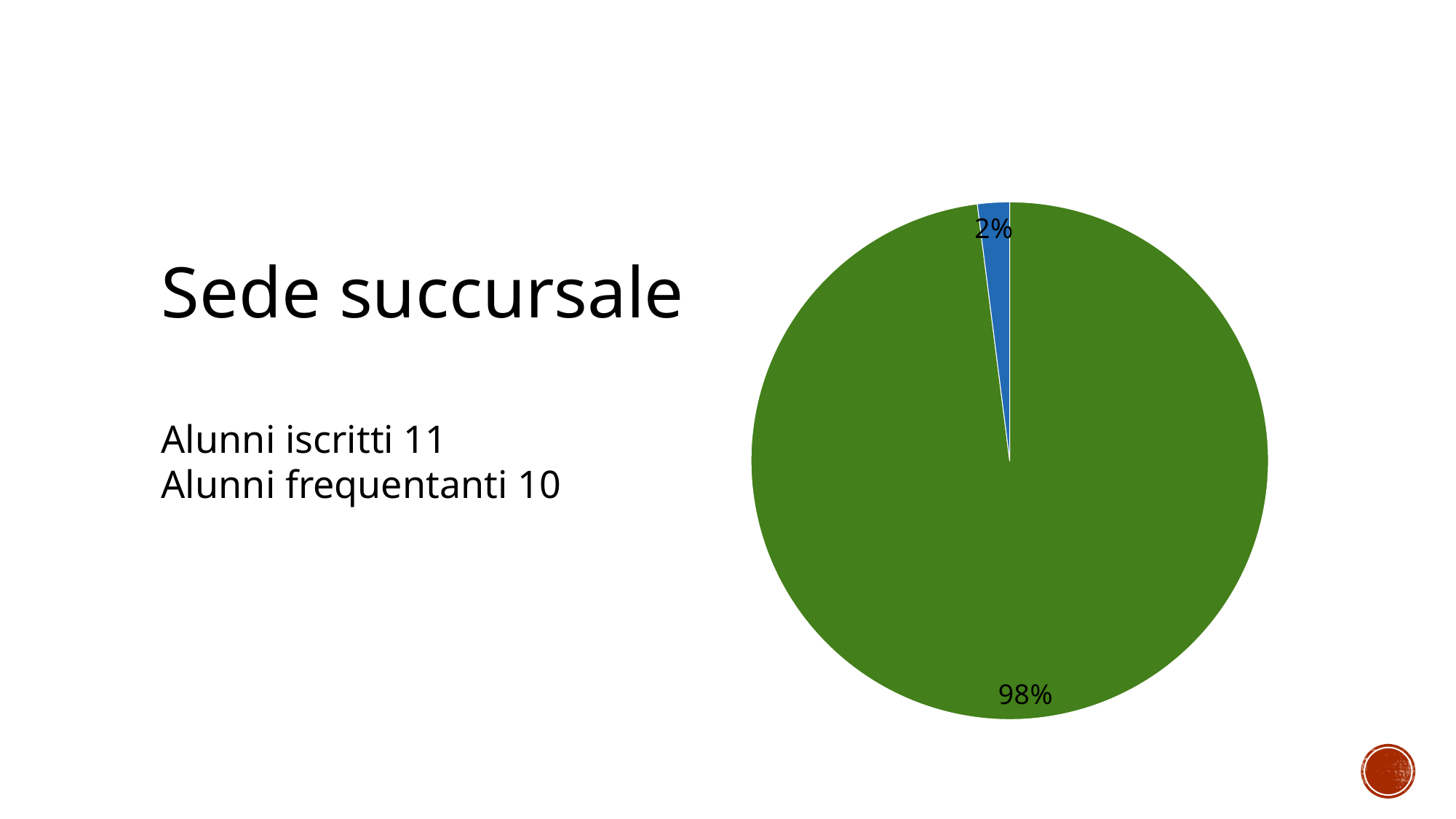
What percentage is shown on the green slice of the pie chart? 98% Is the share of the blue slice greater or less than 50%? less What colour is the slice labelled 98%? green What percentage is shown on the blue slice of the pie chart? 2% Which slice of the pie chart is the largest? the green slice (98%) What kind of chart is shown on the slide? pie chart How many slices does the pie chart have? 2 Which slice of the pie chart is the smallest? the blue slice (2%) Does the pie chart have a legend? No What is the difference in percentage points between the green slice and the blue slice? 96 What is the total of the two percentages shown on the pie chart? 100% Which is larger, the blue slice or the green slice? the green slice